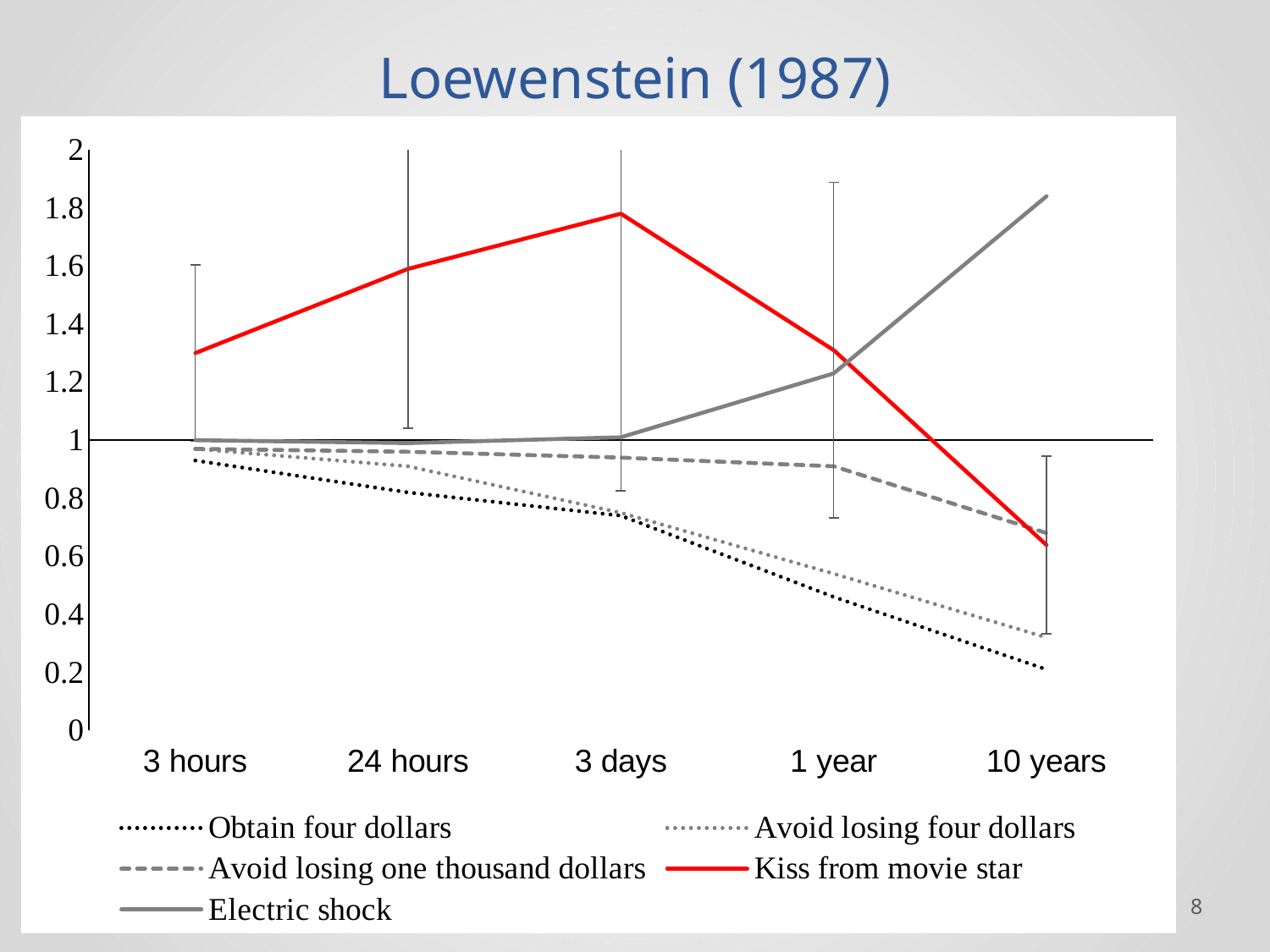
Which series has the highest value at 10 years? Electric shock Does the Obtain four dollars series rise or fall from 3 hours to 10 years? fall At 3 hours, which is larger: Kiss from movie star or Electric shock? Kiss from movie star Which series has the highest value at 3 days? Kiss from movie star What kind of chart is shown on the slide? line chart Is the value for Obtain four dollars at 10 years greater or less than 0.4? less Is the value for Kiss from movie star at 3 days greater or less than 1.6? greater Which series has the lowest value at 10 years? Obtain four dollars What is the title of the slide? Loewenstein (1987) How many time categories are shown on the x axis? 5 Is the value for Electric shock at 10 years greater or less than 1.6? greater How many series does the legend list? 5